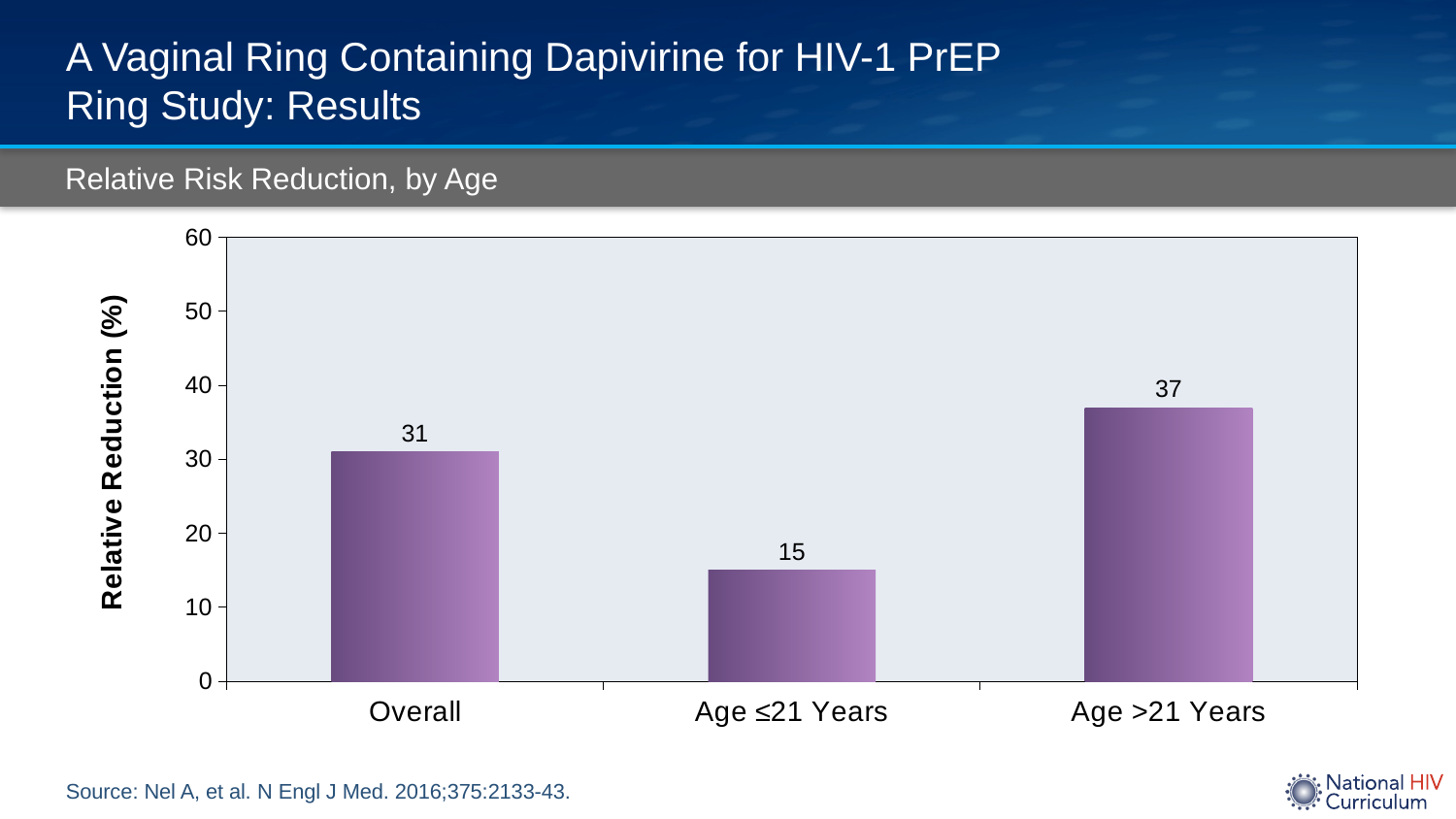
What is the difference in relative reduction between Age >21 Years and Age ≤21 Years? 22 Is the value for Age ≤21 Years greater or less than 20? less How many categories are shown on the x axis? 3 What is the label of the y axis? Relative Reduction (%) Which category has the lowest relative reduction? Age ≤21 Years What kind of chart is shown on the slide? Bar chart What is the relative reduction (%) for the Overall category? 31 Which has a larger relative reduction, Overall or Age ≤21 Years? Overall What is the relative reduction (%) for Age >21 Years? 37 Which category has the highest relative reduction? Age >21 Years What is the relative reduction (%) for Age ≤21 Years? 15 What is the difference in relative reduction between Age >21 Years and Overall? 6